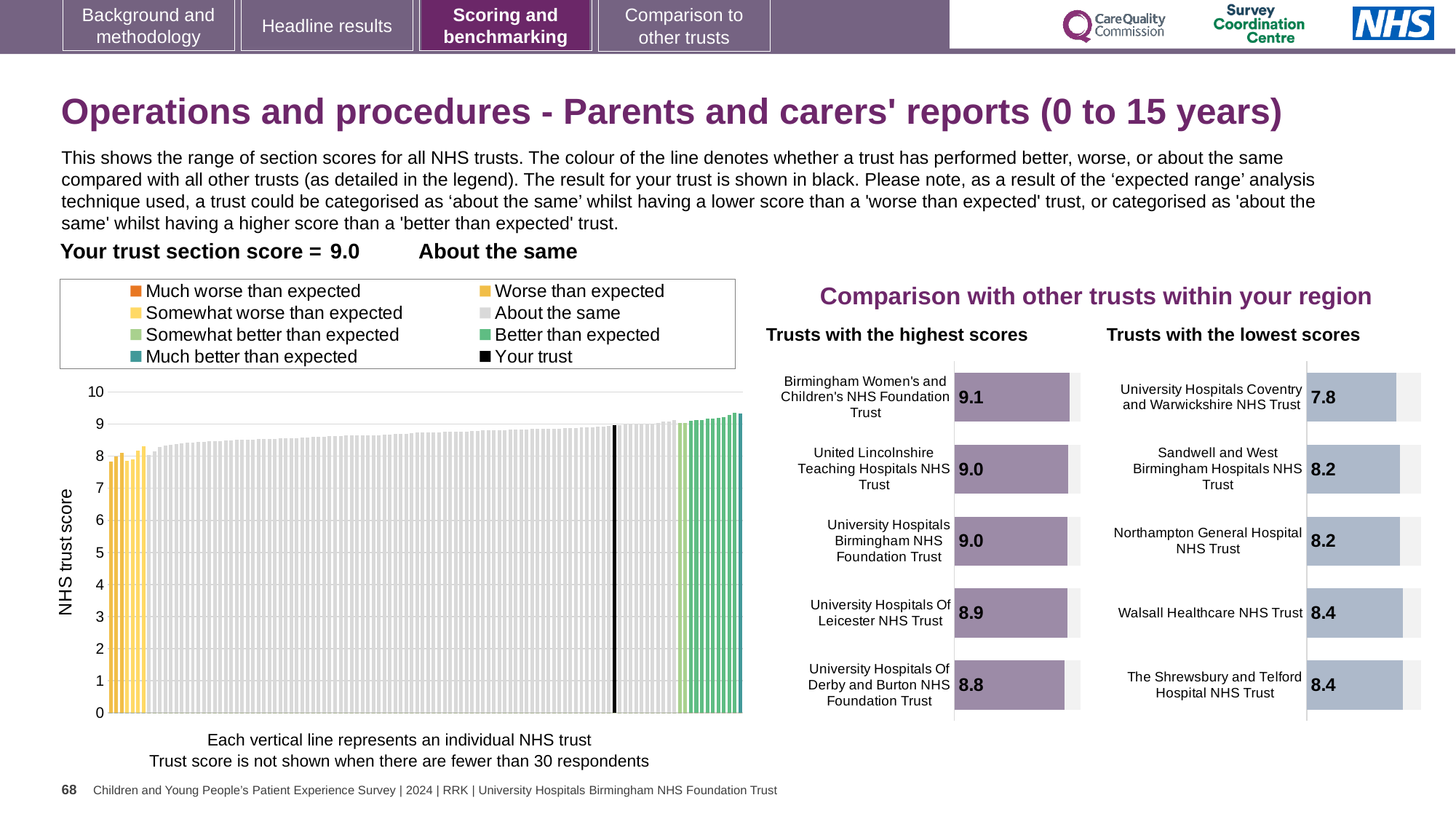
In the 'Trusts with the highest scores' chart, what is the score for University Hospitals Of Leicester NHS Trust? 8.9 In the large chart on the left showing all NHS trusts, is the value for the black 'Your trust' bar greater or less than 8? greater What kind of chart is the large chart on the left showing all NHS trusts? Bar chart In the 'Trusts with the lowest scores' chart, what is the score for University Hospitals Coventry and Warwickshire NHS Trust? 7.8 How many trusts are shown in the 'Trusts with the highest scores' chart? 5 In the 'Trusts with the lowest scores' chart, what is the difference between the scores of The Shrewsbury and Telford Hospital NHS Trust and University Hospitals Coventry and Warwickshire NHS Trust? 0.6 In the 'Trusts with the highest scores' chart, what is the difference between the scores of Birmingham Women's and Children's NHS Foundation Trust and University Hospitals Of Derby and Burton NHS Foundation Trust? 0.3 In the 'Trusts with the lowest scores' chart, which trust has the lowest score? University Hospitals Coventry and Warwickshire NHS Trust In the 'Trusts with the highest scores' chart, what is the score for Birmingham Women's and Children's NHS Foundation Trust? 9.1 In the 'Trusts with the lowest scores' chart, which has the larger score: Walsall Healthcare NHS Trust or University Hospitals Coventry and Warwickshire NHS Trust? Walsall Healthcare NHS Trust In the 'Trusts with the lowest scores' chart, what is the score for Walsall Healthcare NHS Trust? 8.4 In the 'Trusts with the highest scores' chart, which trust has the highest score? Birmingham Women's and Children's NHS Foundation Trust